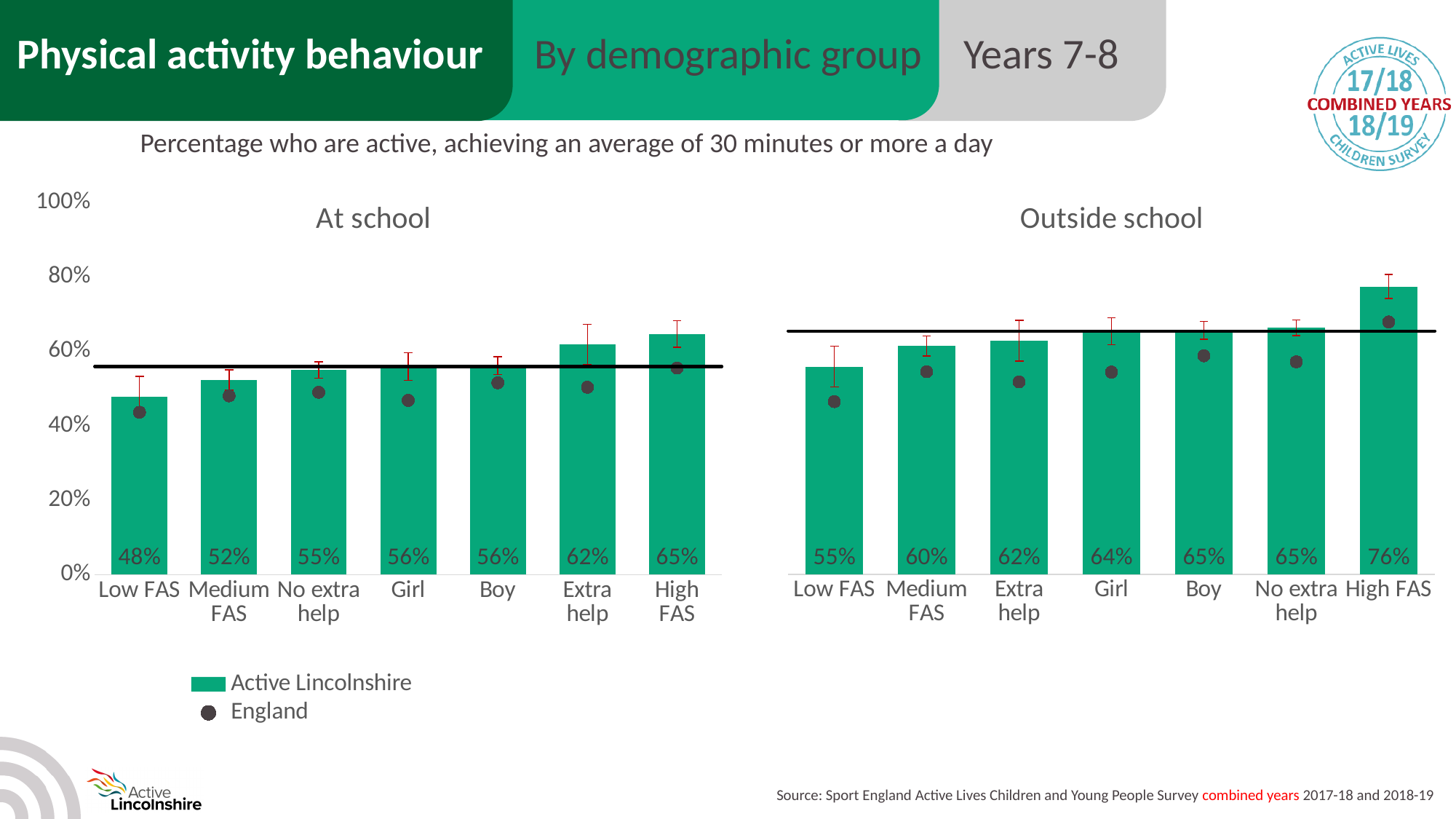
In the 'At school' chart, what is the difference between the Active Lincolnshire values for High FAS and Low FAS? 17% In the 'At school' chart, what is the Active Lincolnshire value for Low FAS? 48% What kind of chart is the 'At school' chart? bar chart In the 'Outside school' chart, do the Active Lincolnshire values rise or fall from Low FAS to High FAS? rise In the 'Outside school' chart, is the England value for Low FAS greater or less than 60%? less How many categories are shown in the 'Outside school' chart? 7 In the 'Outside school' chart, what is the difference between the Active Lincolnshire values for Medium FAS and Low FAS? 5% In the 'At school' chart, which category has the highest Active Lincolnshire value? High FAS In the 'Outside school' chart, what is the Active Lincolnshire value for High FAS? 76% In the 'Outside school' chart, which category has the lowest Active Lincolnshire value? Low FAS In the 'At school' chart, which has the larger Active Lincolnshire value, Extra help or Medium FAS? Extra help How many series does the legend list? 2